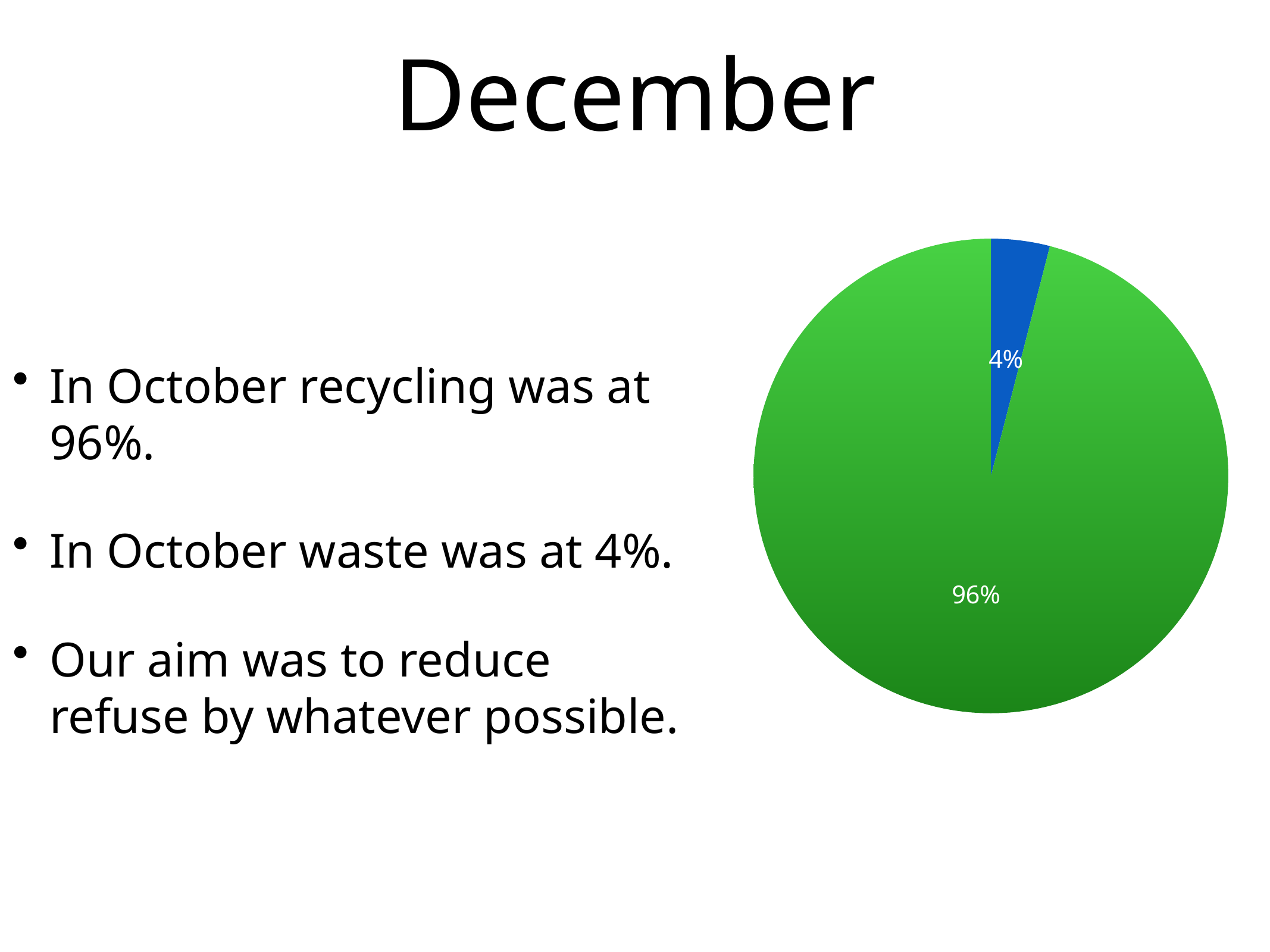
Which slice of the pie chart is the smallest? the blue slice (4%) What is the difference in percentage points between the green slice and the blue slice? 92 Which slice of the pie chart is the largest? the green slice (96%) What share of the pie does the blue slice represent? 4% What percentage is labelled on the green slice of the pie chart? 96% What do the two labelled slices of the pie chart add up to? 100% How many slices does the pie chart have? 2 Is the green slice greater or less than 50% of the pie? greater Which is larger, the green slice or the blue slice? the green slice What kind of chart is shown on the slide? pie chart What colour is the slice labelled 4%? blue What percentage is labelled on the blue slice of the pie chart? 4%